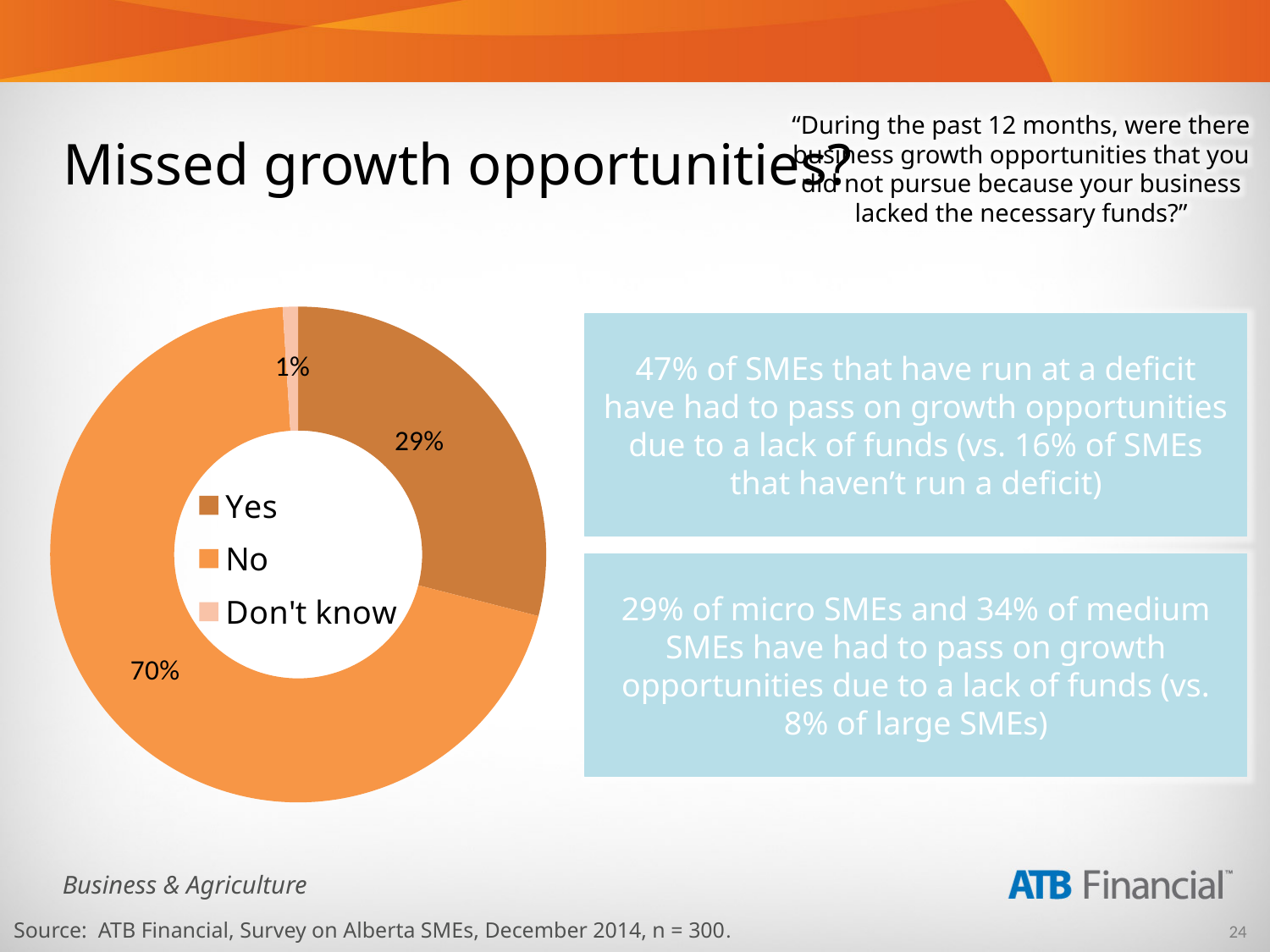
Which response has the largest share of the pie? No How many entries does the legend list? 3 What percentage of respondents answered Yes? 29% Which response has the smallest share of the pie? Don't know Which is larger, the share for Yes or the share for No? No What is the title of the slide containing the chart? Missed growth opportunities? What percentage of respondents answered Don't know? 1% What is the difference in percentage points between the No and Yes responses? 41 What percentage of respondents answered No? 70% How many response categories are shown in the chart? 3 What is the share of the pie for the Yes response? 29% What kind of chart is shown on the slide? Pie chart (doughnut)